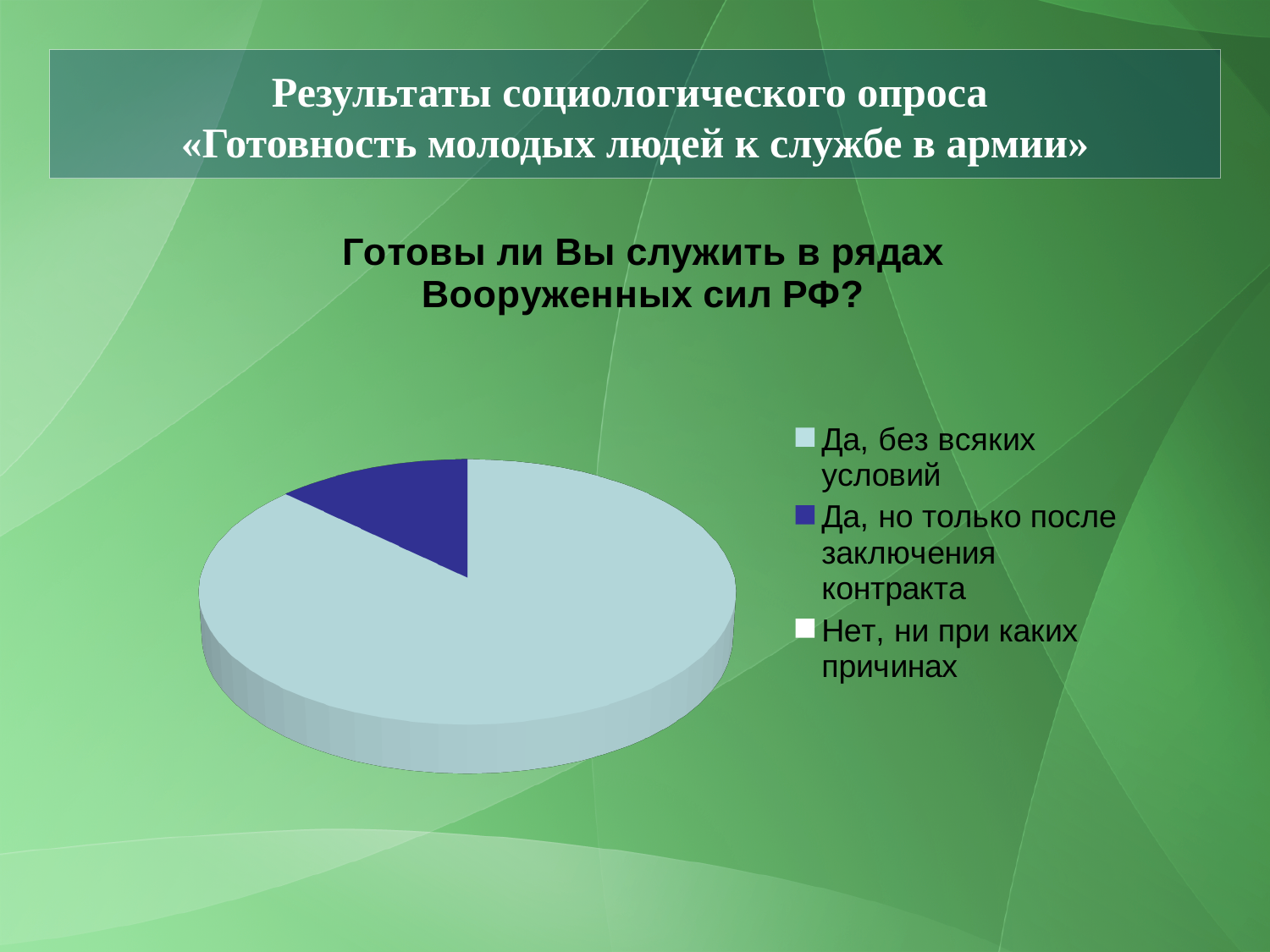
What is the title of the chart? Готовы ли Вы служить в рядах Вооруженных сил РФ? Which slice is larger: "Да, без всяких условий" or "Да, но только после заключения контракта"? Да, без всяких условий Which answer option has the largest slice of the pie? Да, без всяких условий Which legend entry is shown in dark blue? Да, но только после заключения контракта What kind of chart is shown on the slide? pie chart How many entries does the chart's legend list? 3